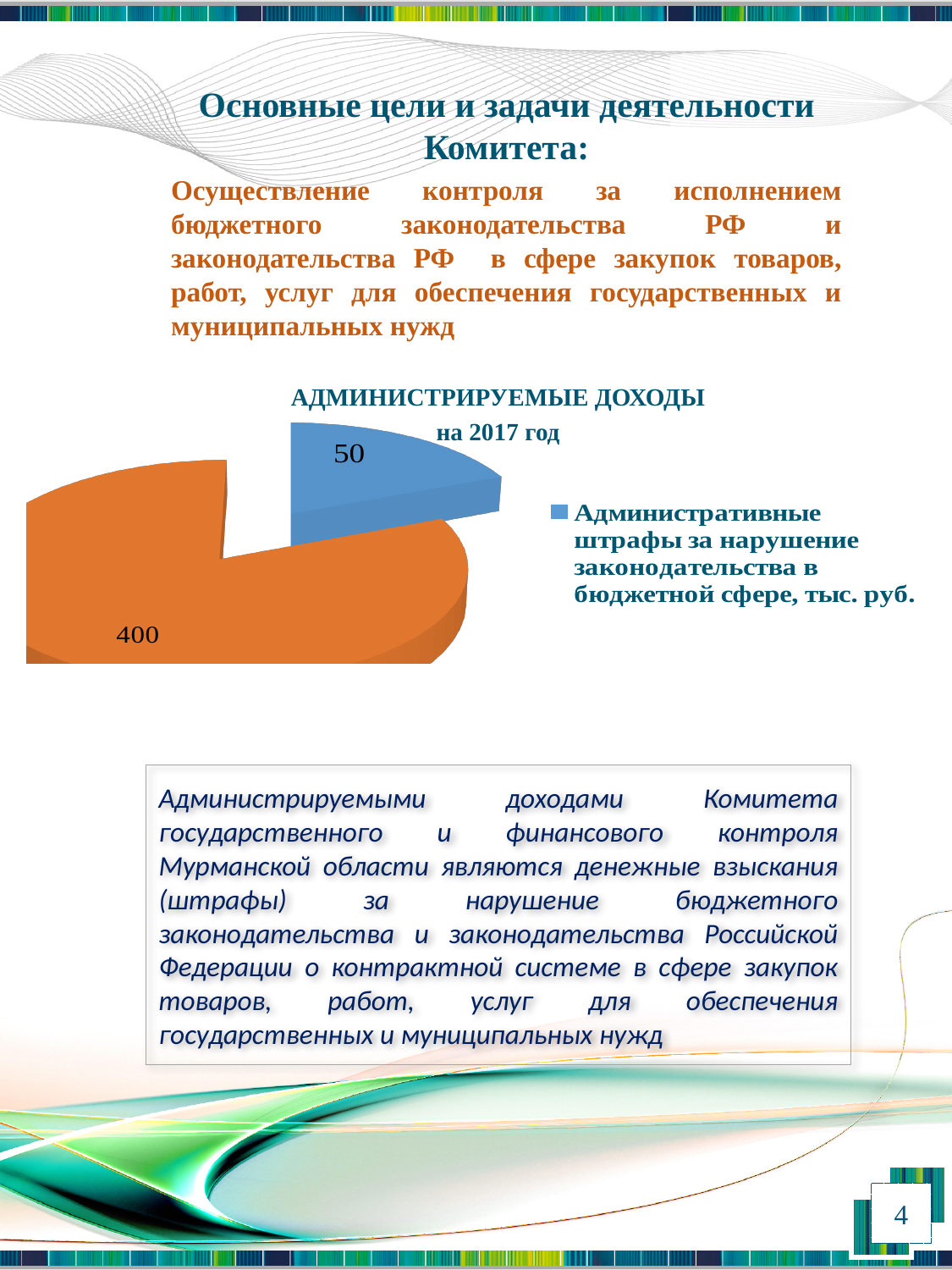
What value is shown on the orange slice of the pie chart? 400 What is the title of the chart? АДМИНИСТРИРУЕМЫЕ ДОХОДЫ на 2017 год How many slices does the pie chart have? 2 Is the orange slice or the blue slice larger? the orange slice What is the difference between the orange slice value and the blue slice value? 350 What is the total of the two values shown on the pie chart? 450 How many entries does the chart legend list? 1 Which slice of the pie chart is the smallest? the blue slice (50) Which slice of the pie chart is the largest? the orange slice (400) What value is shown for the blue slice, 'Административные штрафы за нарушение законодательства в бюджетной сфере, тыс. руб.'? 50 What kind of chart is shown on the slide? pie chart